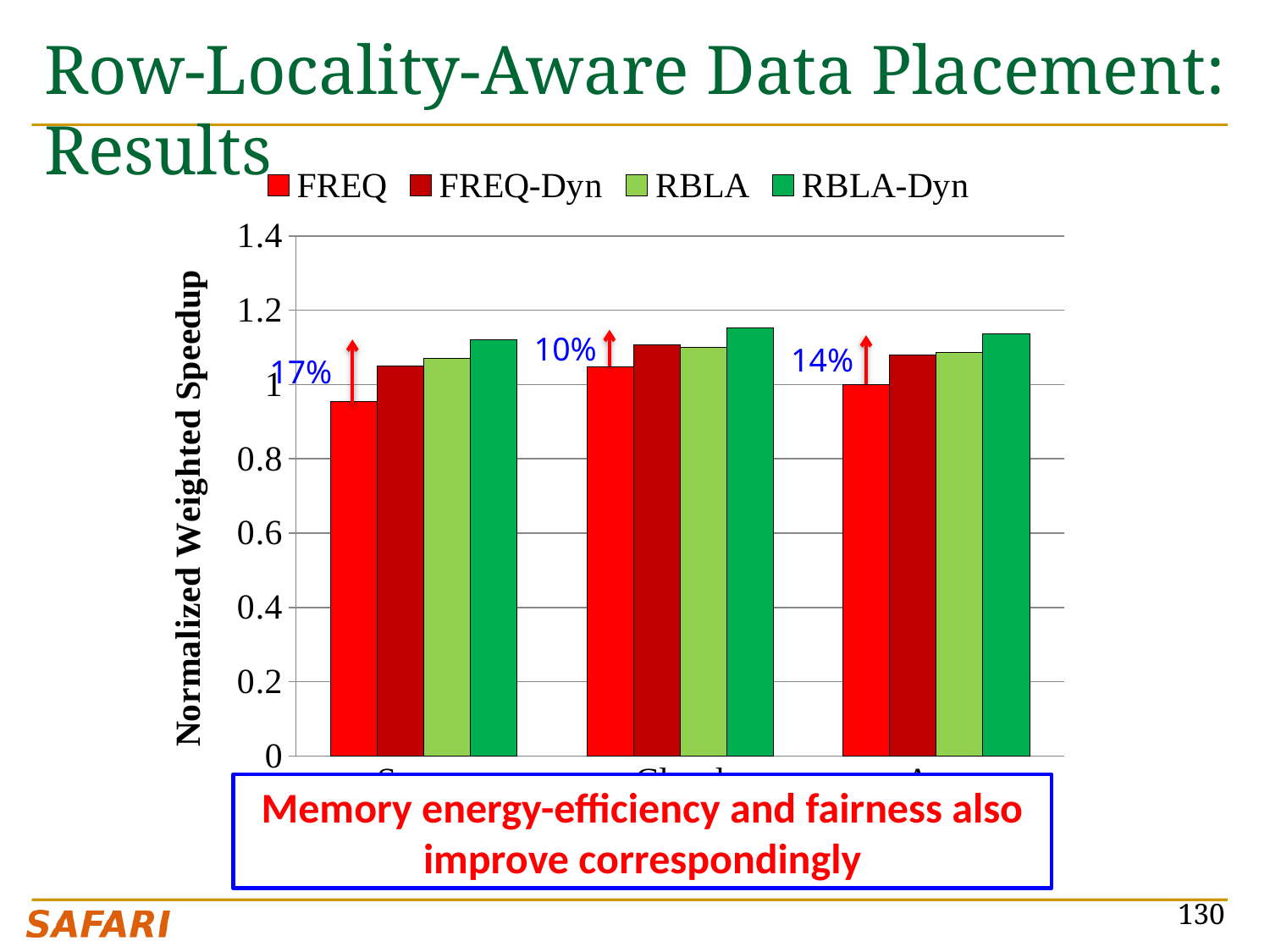
Is the RBLA-Dyn value in the rightmost group greater or less than 1.2? less Is the RBLA-Dyn value in the middle group greater or less than 1? greater How many groups of bars are plotted in the chart? 3 In the middle group of bars, which series has the highest value? RBLA-Dyn Which series is shown in dark green in the legend? RBLA-Dyn Is the FREQ value in the leftmost group greater or less than 1? less How many series does the legend list? 4 In the leftmost group of bars, which series has the highest value? RBLA-Dyn What percentage improvement is annotated above the leftmost group of bars? 17% What is the title of the y axis? Normalized Weighted Speedup In the leftmost group of bars, which series has the lowest value? FREQ What kind of chart is shown on the slide? bar chart